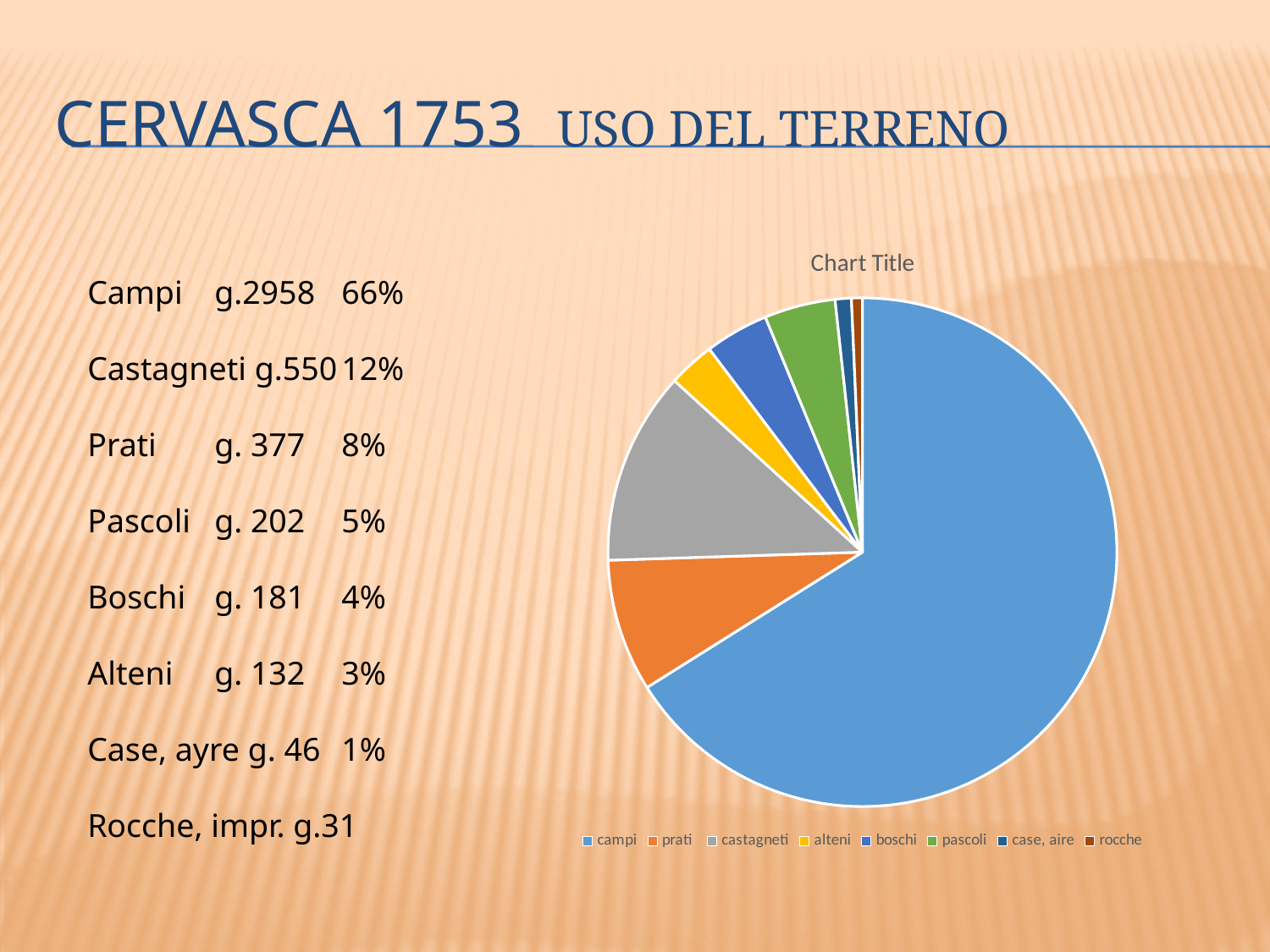
What colour is the campi slice in the pie chart? blue Which slice is larger, pascoli or alteni? pascoli Which category has the largest slice of the pie chart? campi How many slices does the pie chart have? 8 What is the value given for Campi on the slide? g.2958 What share of the pie does campi represent, according to the slide? 66% Which slice is larger, castagneti or prati? castagneti What share of the pie does castagneti represent, according to the slide? 12% How many entries does the pie chart's legend list? 8 What kind of chart is shown on the slide? pie chart Which category has the smallest slice of the pie chart? rocche What is the title shown above the pie chart? Chart Title